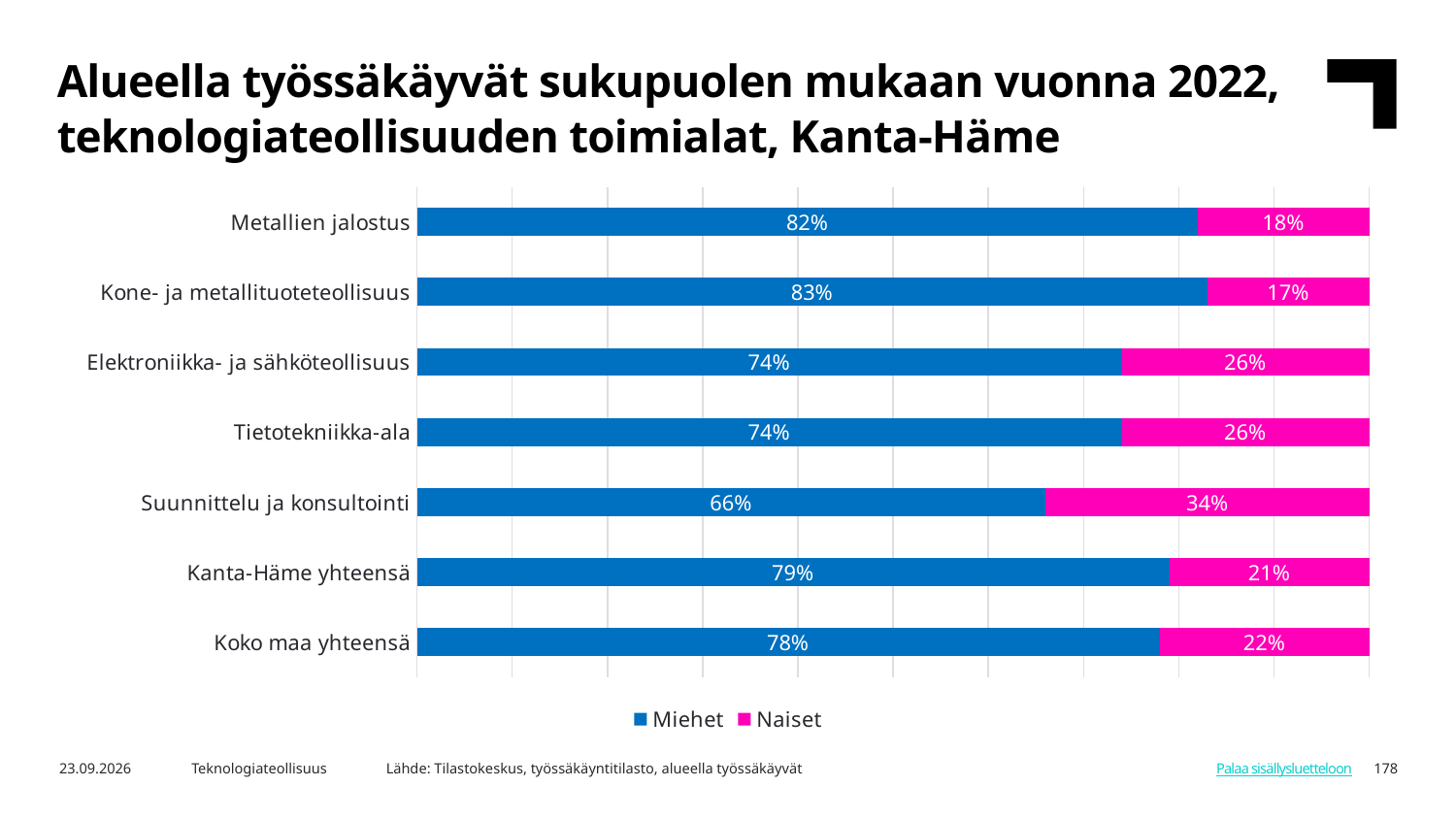
How many series does the legend list? 2 Which category has the highest Miehet share? Kone- ja metallituoteteollisuus Which colour represents Naiset in the chart? Magenta (pink) Which category has the lowest Miehet share? Suunnittelu ja konsultointi Which has a larger Naiset share, Kanta-Häme yhteensä or Koko maa yhteensä? Koko maa yhteensä What is the difference in percentage points between the Naiset share for Suunnittelu ja konsultointi and for Metallien jalostus? 16 What is the Miehet share for Koko maa yhteensä? 78% What is the Naiset share for Suunnittelu ja konsultointi? 34% How many categories are shown on the chart? 7 What is the Miehet share for Metallien jalostus? 82% What kind of chart is shown on the slide? Stacked bar chart What is the Naiset share for Kone- ja metallituoteteollisuus? 17%